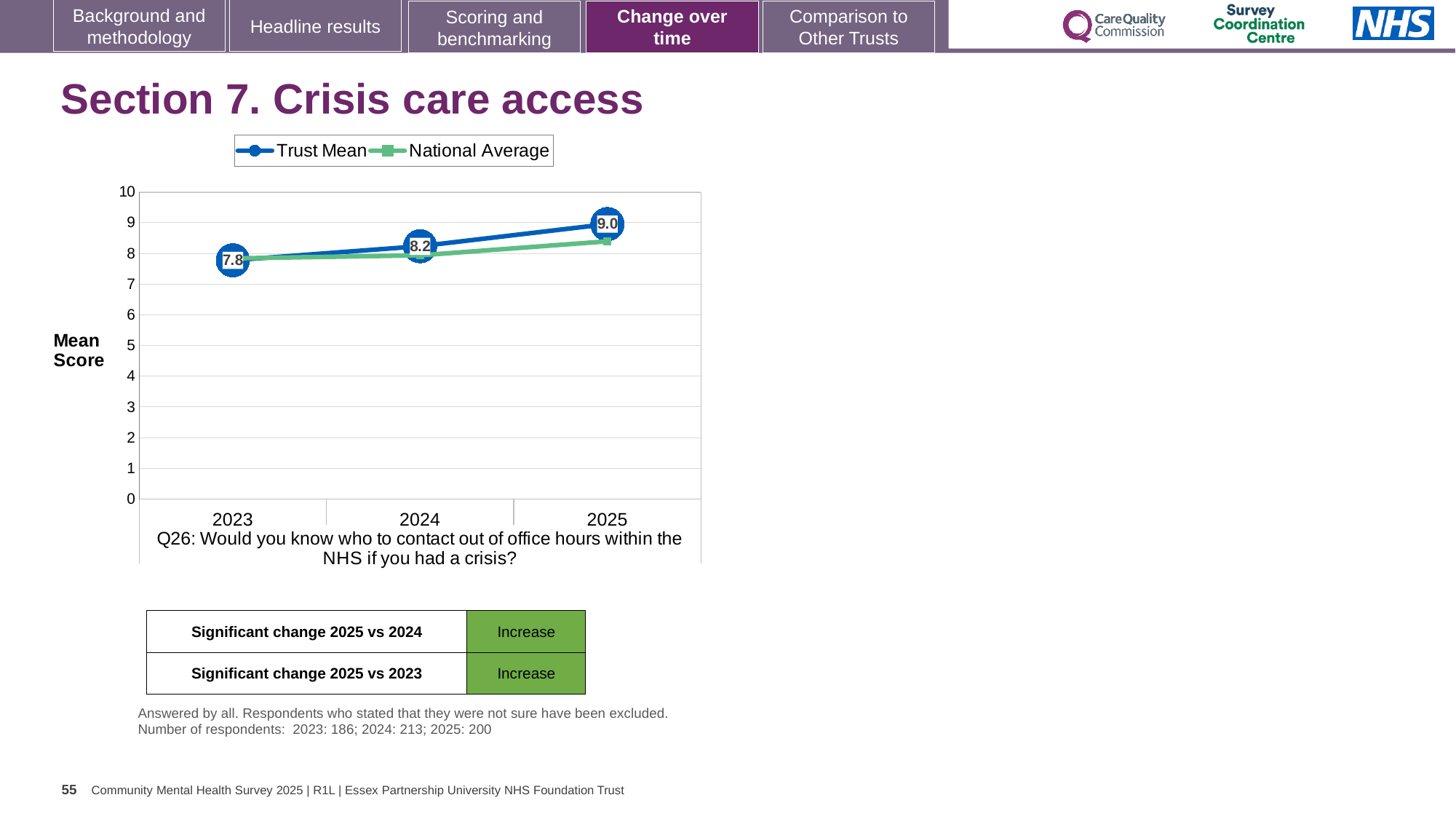
What kind of chart is shown on the slide? Line chart What is the difference between the Trust Mean in 2025 and in 2024? 0.8 How many series does the legend list? 2 Is the National Average value for 2025 greater or less than 8? greater What is the Trust Mean score for 2025? 9.0 How many years are plotted on the x axis? 3 In which year is the Trust Mean highest? 2025 What is the Trust Mean score for 2024? 8.2 In which year is the Trust Mean lowest? 2023 What is the Trust Mean score for 2023? 7.8 What is the difference between the Trust Mean in 2025 and in 2023? 1.2 Which is larger, the Trust Mean in 2024 or in 2025? 2025